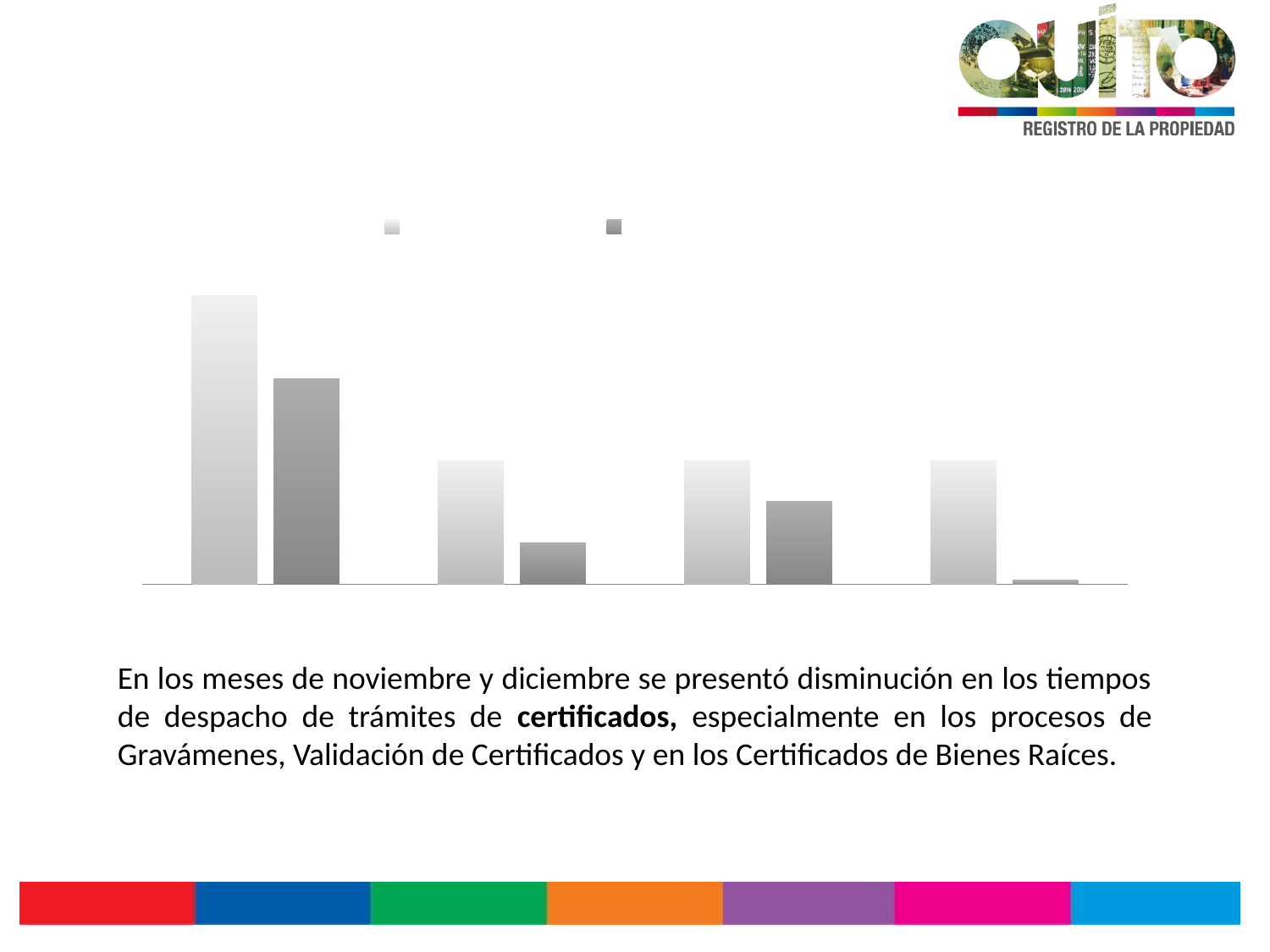
What two colours are used for the bars in the chart? light grey and dark grey In the rightmost group of bars, which bar is taller, the light grey one or the dark grey one? the light grey one In the leftmost group of bars, which bar is taller, the light grey one or the dark grey one? the light grey one Which group of bars contains the tallest bar in the chart? the leftmost group How many series does the legend of the chart list? 2 Which group of bars contains the shortest bar in the chart? the rightmost group What kind of chart is shown on the slide? bar chart How many groups of bars are plotted in the chart? 4